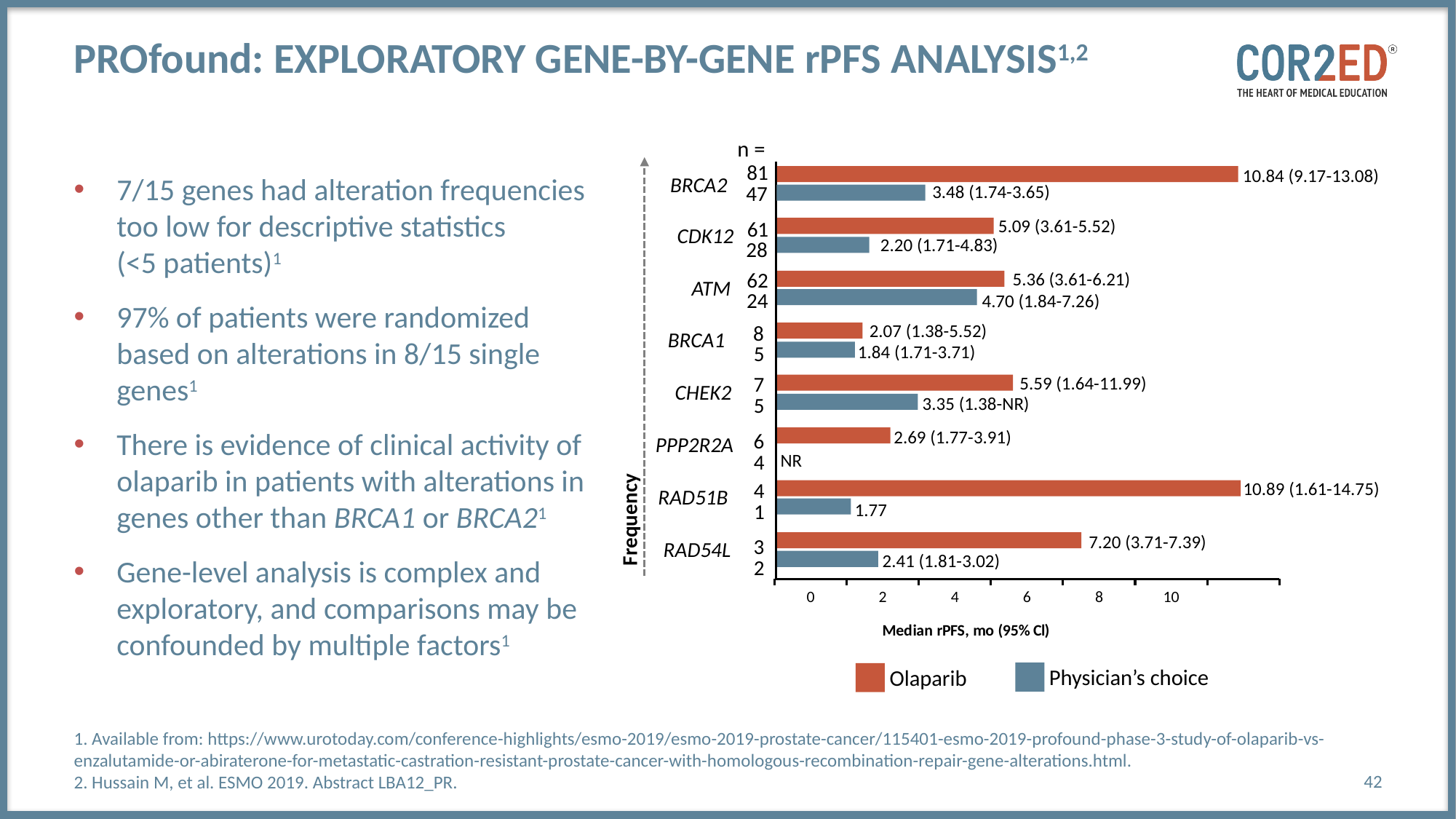
What is the difference between the olaparib and physician's choice median rPFS in the BRCA2 group? 7.36 In the ATM group, which arm has the higher median rPFS, olaparib or physician's choice? Olaparib How many genes are shown on the chart? 8 How many series does the legend list? 2 What is the median rPFS for physician's choice in the PPP2R2A group? NR Is the olaparib median rPFS for RAD54L greater or less than 6? greater What is the median rPFS for olaparib in patients with BRCA2 alterations? 10.84 (9.17-13.08) Which gene has the highest median rPFS for physician's choice? ATM How many patients (n) were in the olaparib arm of the CDK12 group? 61 Which gene has the lowest median rPFS for olaparib? BRCA1 What kind of chart is shown on the slide? Bar chart What is the median rPFS for physician's choice in patients with ATM alterations? 4.70 (1.84-7.26)